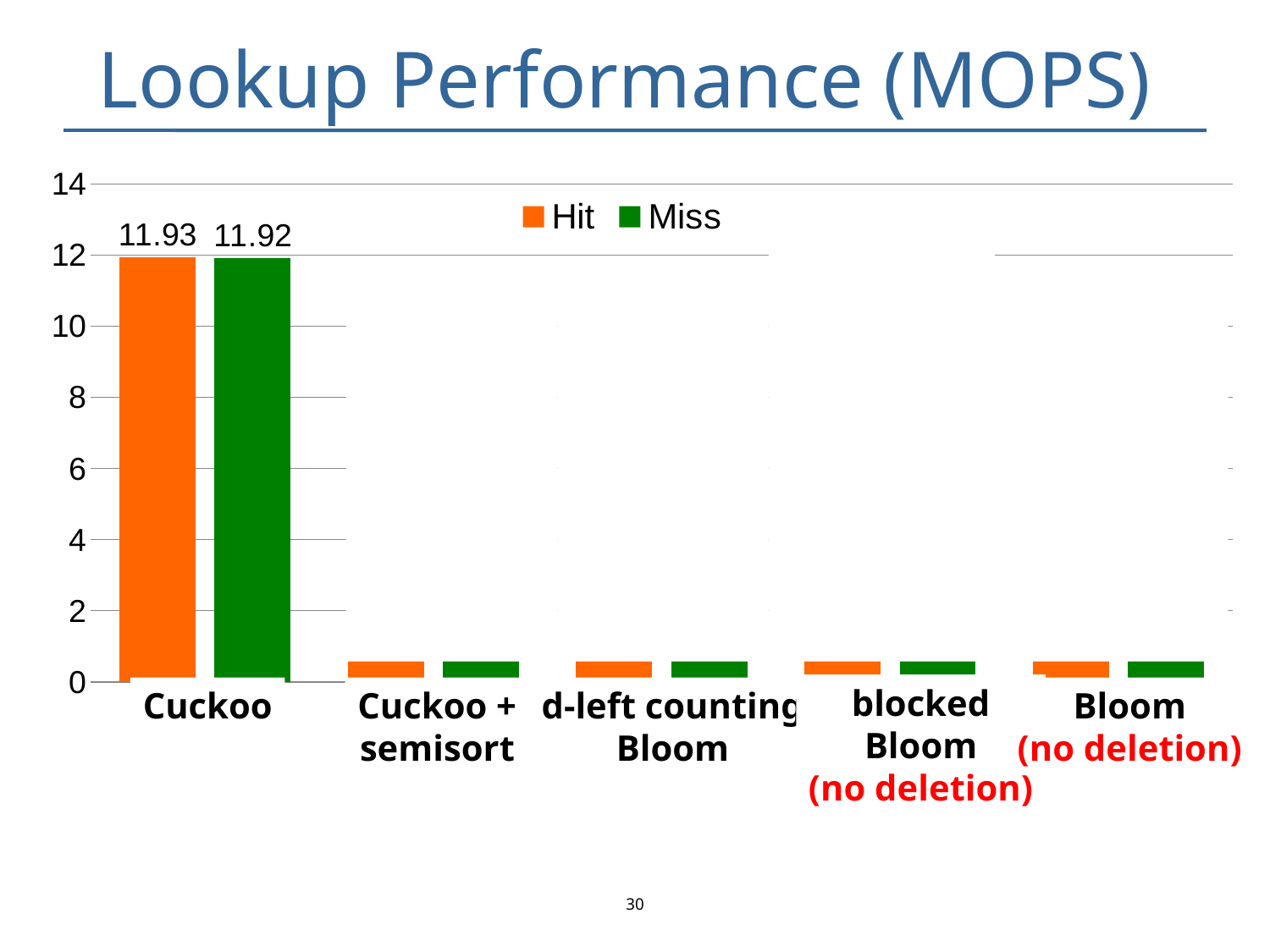
Which category has the highest Hit value? Cuckoo Is the Miss value for Bloom (no deletion) greater or less than 2? less How many categories are shown on the x axis? 5 Is the Hit value for Cuckoo greater or less than 10? greater What is the difference between the Hit and Miss values for Cuckoo? 0.01 Is the Hit value for Cuckoo + semisort greater or less than 2? less What kind of chart is shown on the slide? bar chart What is the Hit value for Cuckoo? 11.93 Which category has the highest Miss value? Cuckoo What is the Miss value for Cuckoo? 11.92 How many series does the legend list? 2 What is the title of the chart? Lookup Performance (MOPS)